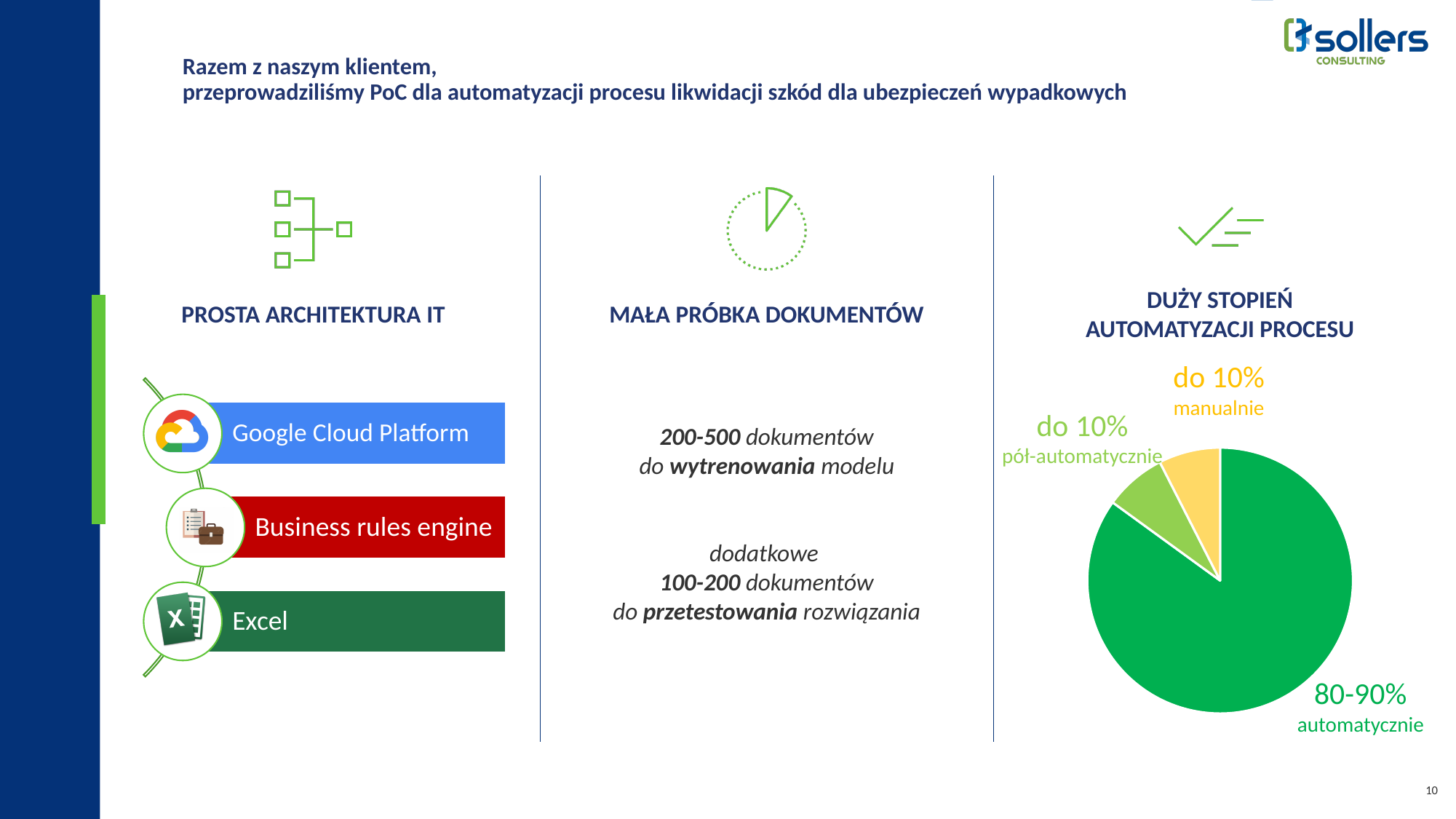
What kind of chart is shown on the slide? pie chart What share is labelled for the 'automatycznie' slice of the pie chart? 80-90% What colour is the 'manualnie' slice of the pie chart? yellow What share is labelled for the 'manualnie' slice of the pie chart? do 10% How many slices does the pie chart have? 3 Which slice is larger in the pie chart: 'pół-automatycznie' or 'automatycznie'? automatycznie Which slice of the pie chart is the largest? automatycznie What heading appears above the pie chart? DUŻY STOPIEŃ AUTOMATYZACJI PROCESU Which slice is larger in the pie chart: 'automatycznie' or 'manualnie'? automatycznie What share is labelled for the 'pół-automatycznie' slice of the pie chart? do 10%